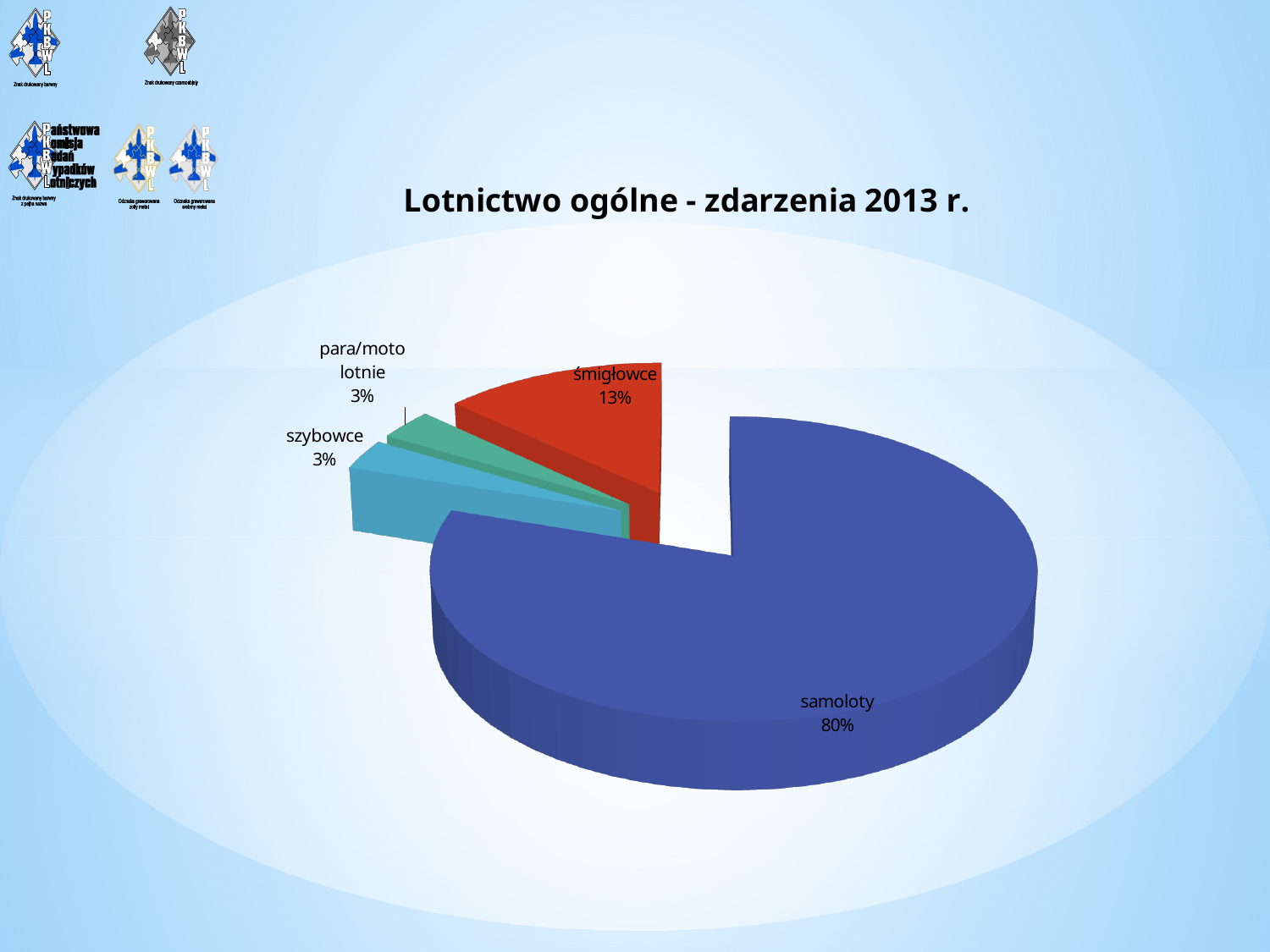
What is the difference in percentage points between the samoloty share and the śmigłowce share? 67 What share of the pie does para/moto lotnie have? 3% What share of the pie does szybowce have? 3% What kind of chart is shown on the slide? pie chart What colour is the samoloty slice? blue What share of the pie does śmigłowce have? 13% Which is larger, the share for śmigłowce or the share for szybowce? śmigłowce How many slices does the pie chart have? 4 Which category has the largest slice of the pie? samoloty What is the title of the chart? Lotnictwo ogólne - zdarzenia 2013 r. What is the difference in percentage points between the śmigłowce share and the para/moto lotnie share? 10